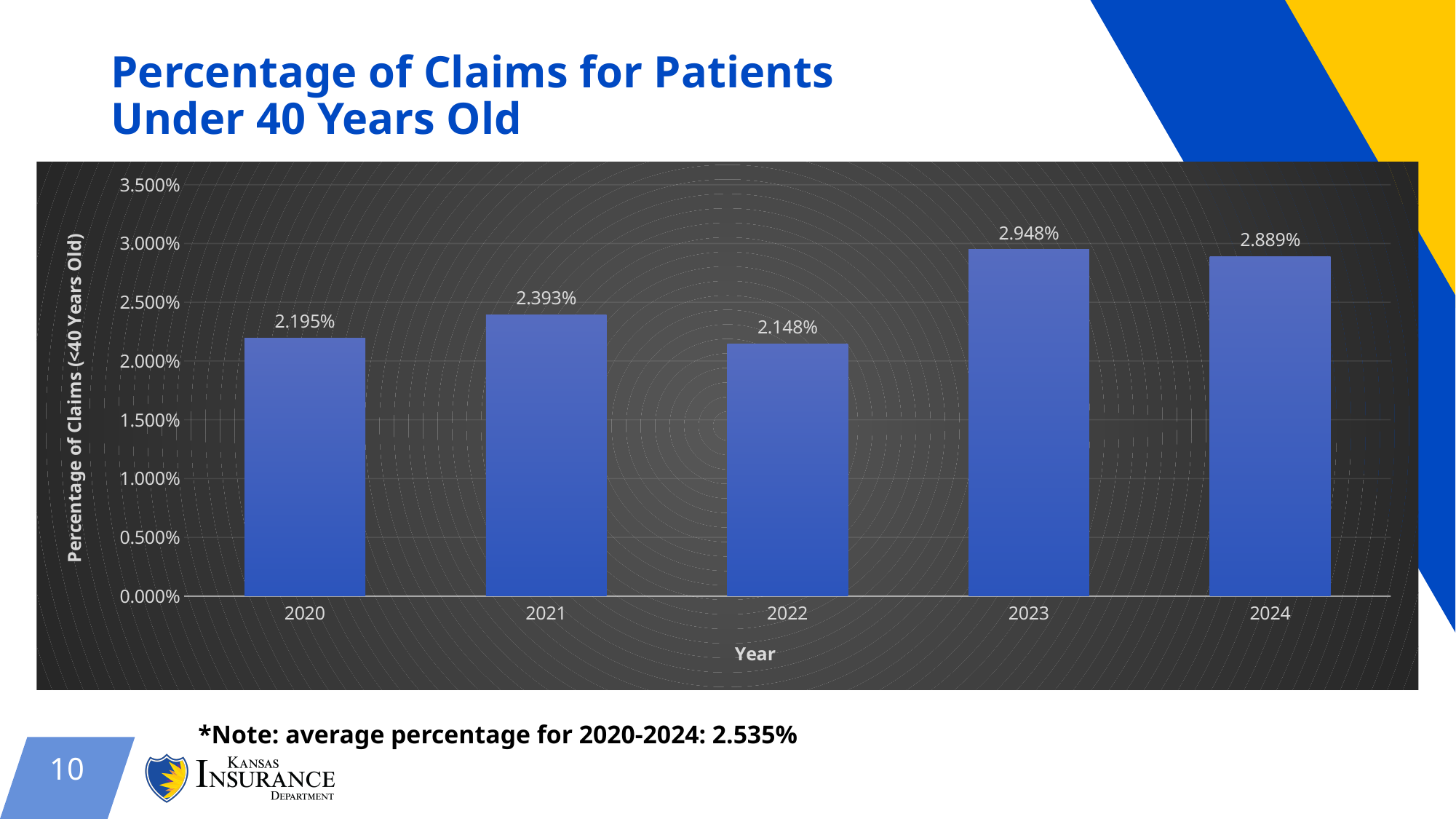
What is the percentage of claims for patients under 40 years old in 2024? 2.889% What is the percentage of claims for patients under 40 years old in 2022? 2.148% Did the percentage of claims for patients under 40 rise or fall from 2021 to 2022? fall Which year has a higher percentage of claims for patients under 40: 2021 or 2024? 2024 How many years are shown on the x axis of the chart? 5 What is the difference between the 2023 and 2022 percentages of claims for patients under 40? 0.800% What is the percentage of claims for patients under 40 years old in 2020? 2.195% Which year has the highest percentage of claims for patients under 40 years old? 2023 Is the value for 2023 greater or less than 2.500%? greater What kind of chart is shown on the slide? bar chart Which year has the lowest percentage of claims for patients under 40 years old? 2022 What is the label of the x axis of the chart? Year